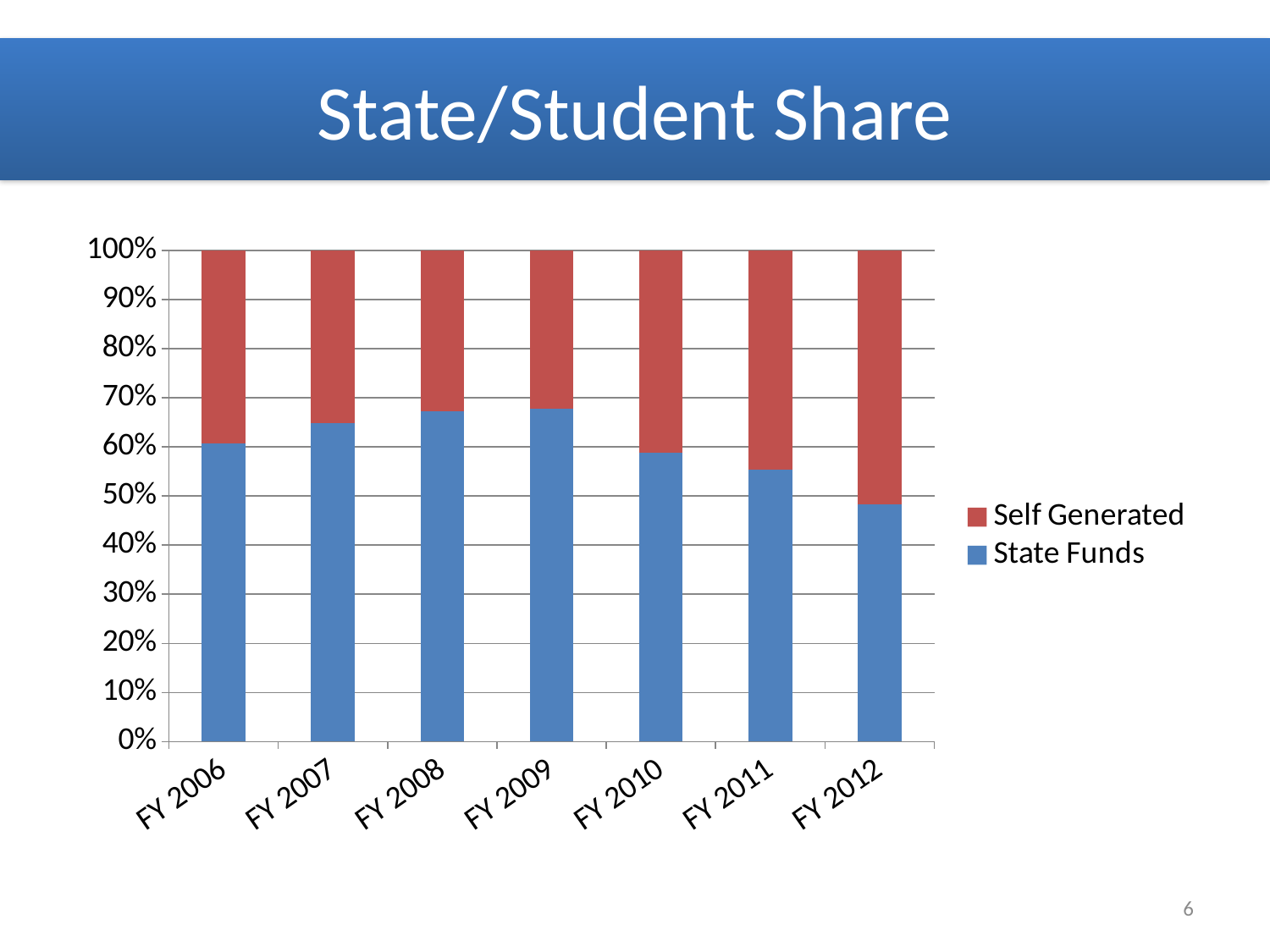
How many series does the legend list? 2 Which is larger, the State Funds share in FY 2007 or in FY 2012? FY 2007 Is the State Funds share for FY 2012 greater or less than 50%? less What kind of chart is shown on the slide? Stacked bar chart Is the State Funds share for FY 2008 greater or less than 60%? greater Which fiscal year has the lowest State Funds share? FY 2012 Is the State Funds share for FY 2011 greater or less than 60%? less What is the title of the chart? State/Student Share Which series is shown in red? Self Generated How many fiscal years are shown on the x axis? 7 Which fiscal year has the highest Self Generated share? FY 2012 Does the State Funds share rise or fall from FY 2009 to FY 2012? fall